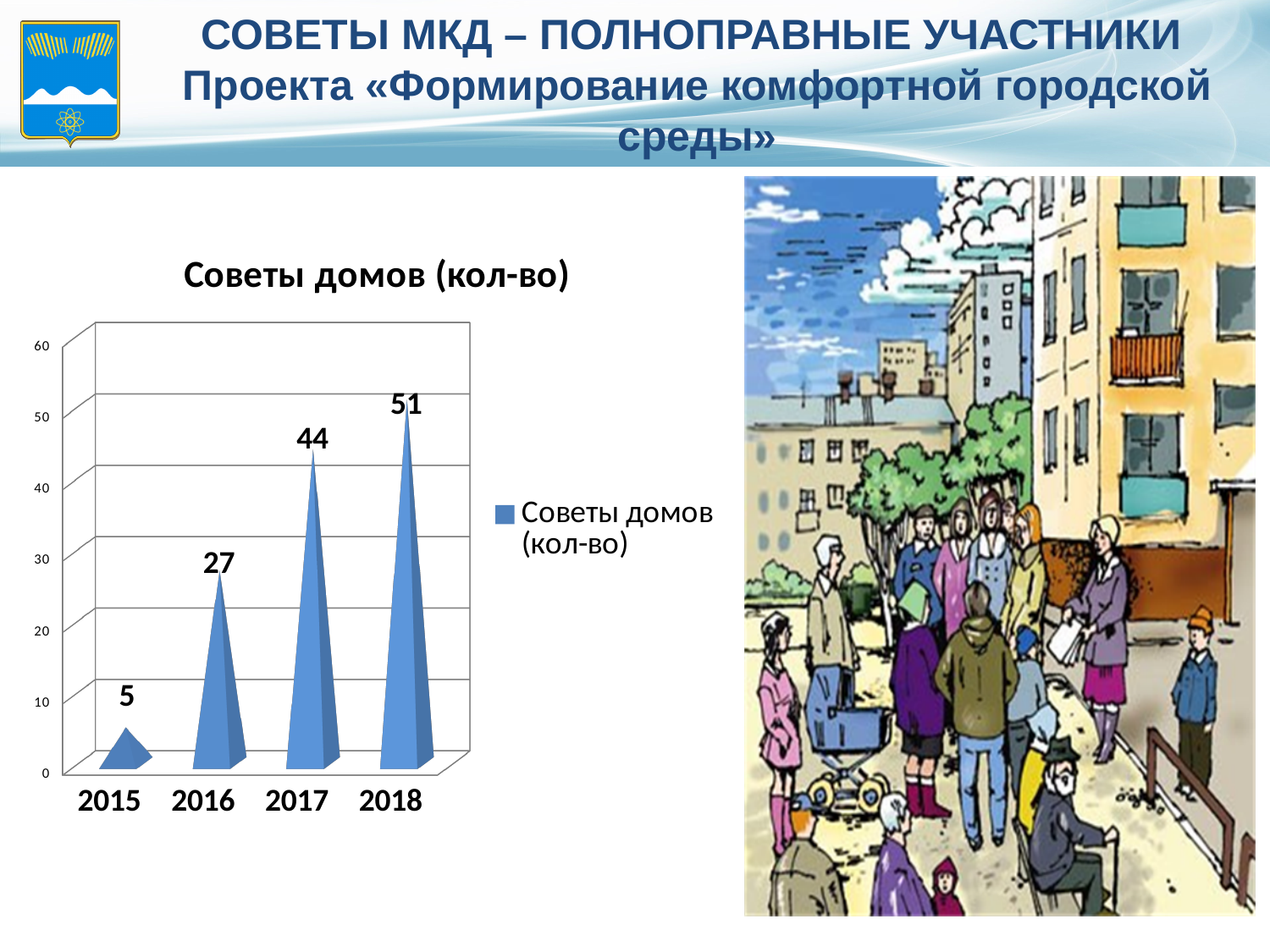
Do the values rise or fall from 2015 to 2018? rise What is the title of the chart? Советы домов (кол-во) What is the value for 2015? 5 What is the difference between the values for 2016 and 2015? 22 Which year has the highest value? 2018 What is the value for 2017? 44 How many years are shown on the x axis? 4 What is the value for 2018? 51 Which is larger, the value for 2016 or the value for 2017? 2017 Which year has the lowest value? 2015 What is the difference between the values for 2018 and 2017? 7 What is the value for 2016? 27